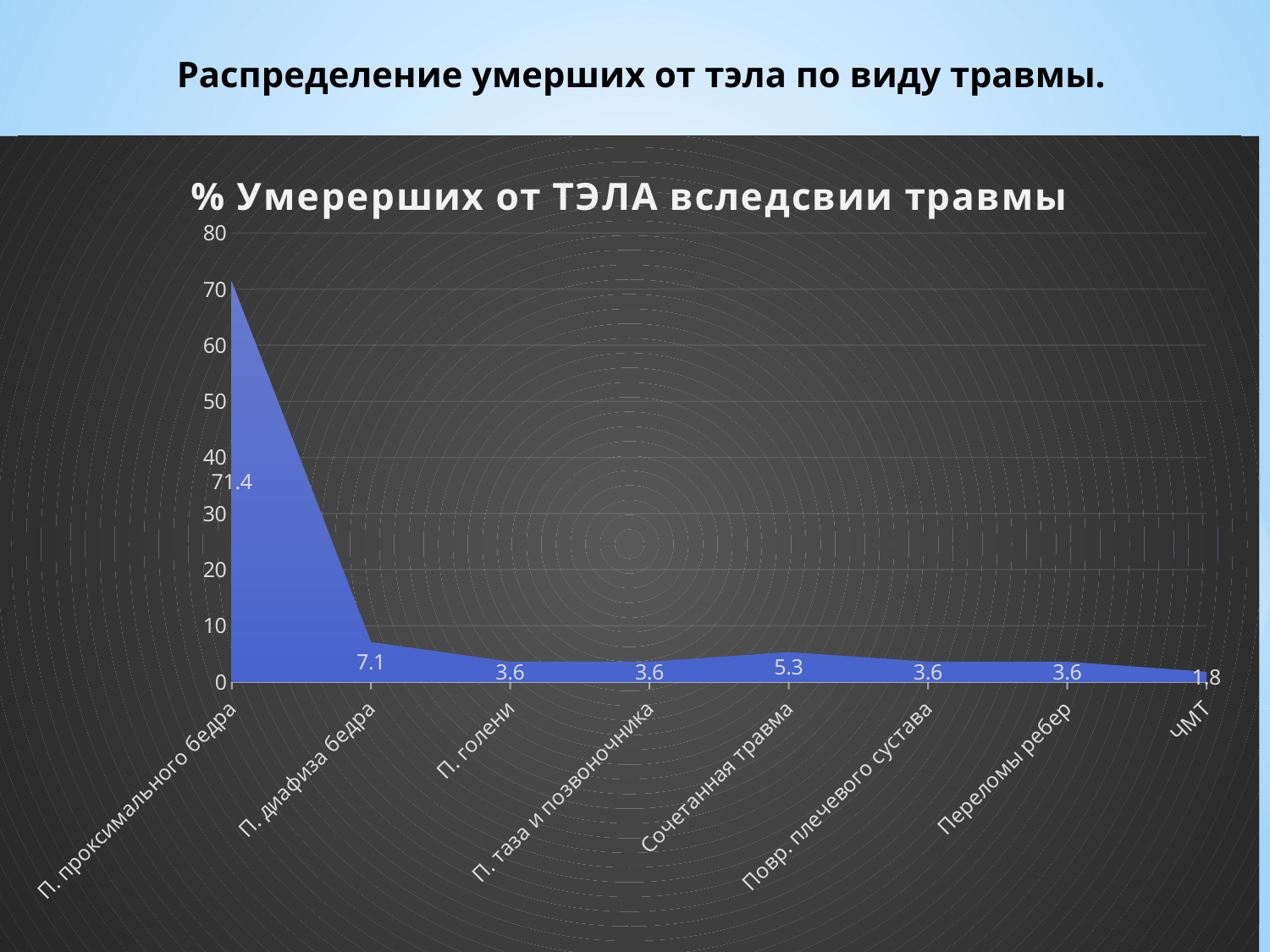
What value is shown for П. диафиза бедра? 7.1 Is the value for П. проксимального бедра greater or less than 60? greater What value is shown for Сочетанная травма? 5.3 What value is shown for П. проксимального бедра? 71.4 Which category has the lowest value? ЧМТ Which category has the highest value? П. проксимального бедра What kind of chart is shown on the slide? area chart What is the title of the chart? % Умерерших от ТЭЛА вследсвии травмы Which is larger, the value for Сочетанная травма or the value for П. голени? Сочетанная травма What is the difference between the values for П. проксимального бедра and П. диафиза бедра? 64.3 How many categories are shown on the x axis? 8 What value is shown for ЧМТ? 1.8